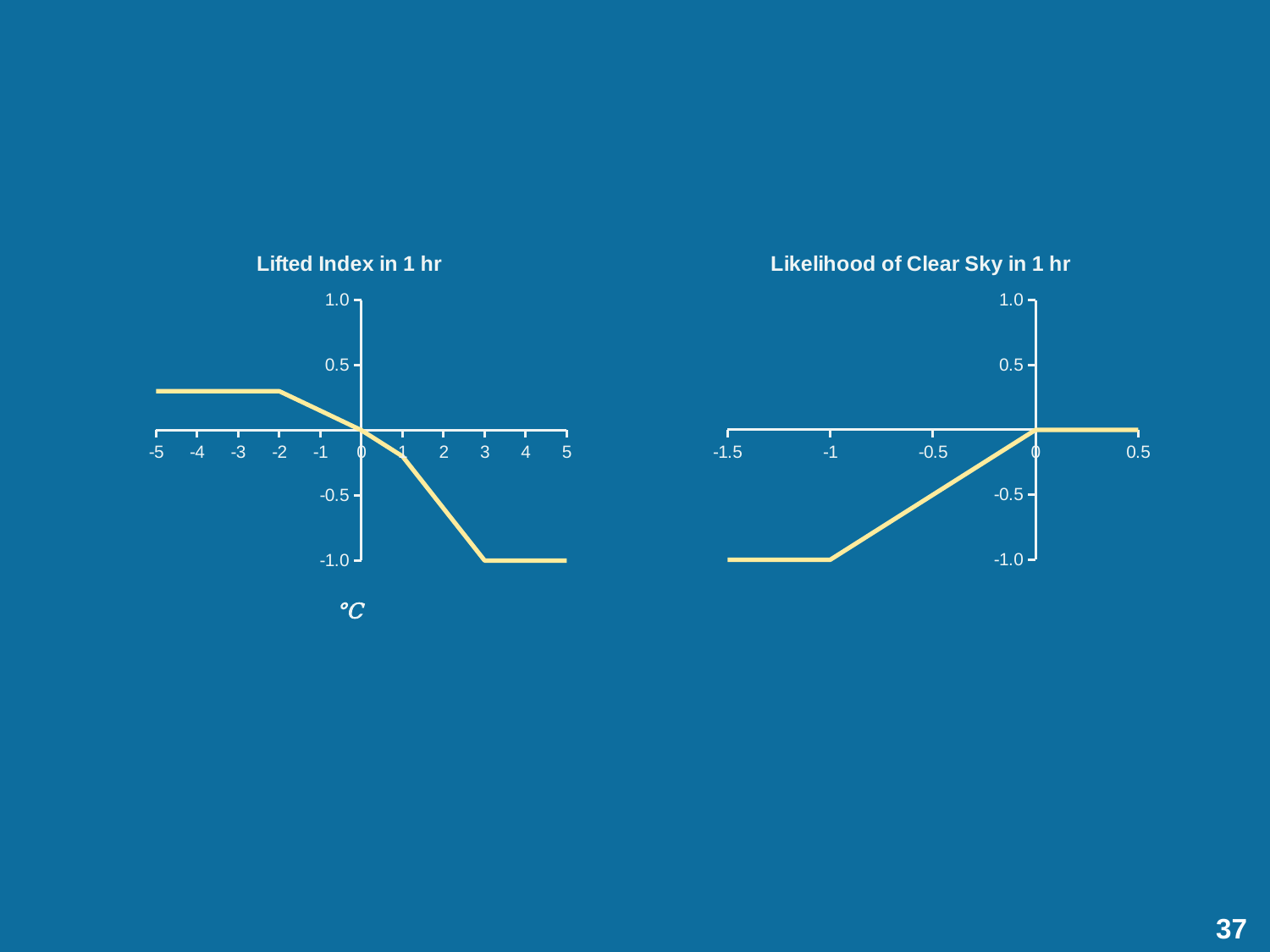
In the "Lifted Index in 1 hr" chart, what is the value of the line at x = 5? -1.0 What type of chart is the "Lifted Index in 1 hr" chart? line chart In the "Lifted Index in 1 hr" chart, is the value of the line at x = -5 greater or less than 0.5? less What unit is shown below the x axis of the "Lifted Index in 1 hr" chart? °C In the "Likelihood of Clear Sky in 1 hr" chart, what is the value of the line at x = 0.5? 0 In the "Lifted Index in 1 hr" chart, is the value of the line at x = -4 greater or less than 0? greater In the "Lifted Index in 1 hr" chart, which is larger: the value at x = -3 or the value at x = 2? the value at x = -3 In the "Likelihood of Clear Sky in 1 hr" chart, does the line rise or fall as x increases from -1 to 0? rise In the "Lifted Index in 1 hr" chart, what is the value of the line at x = 3? -1.0 What type of chart is the "Likelihood of Clear Sky in 1 hr" chart? line chart In the "Likelihood of Clear Sky in 1 hr" chart, what is the value of the line at x = -1? -1.0 In the "Lifted Index in 1 hr" chart, does the line rise or fall as x increases from -2 to 3? fall